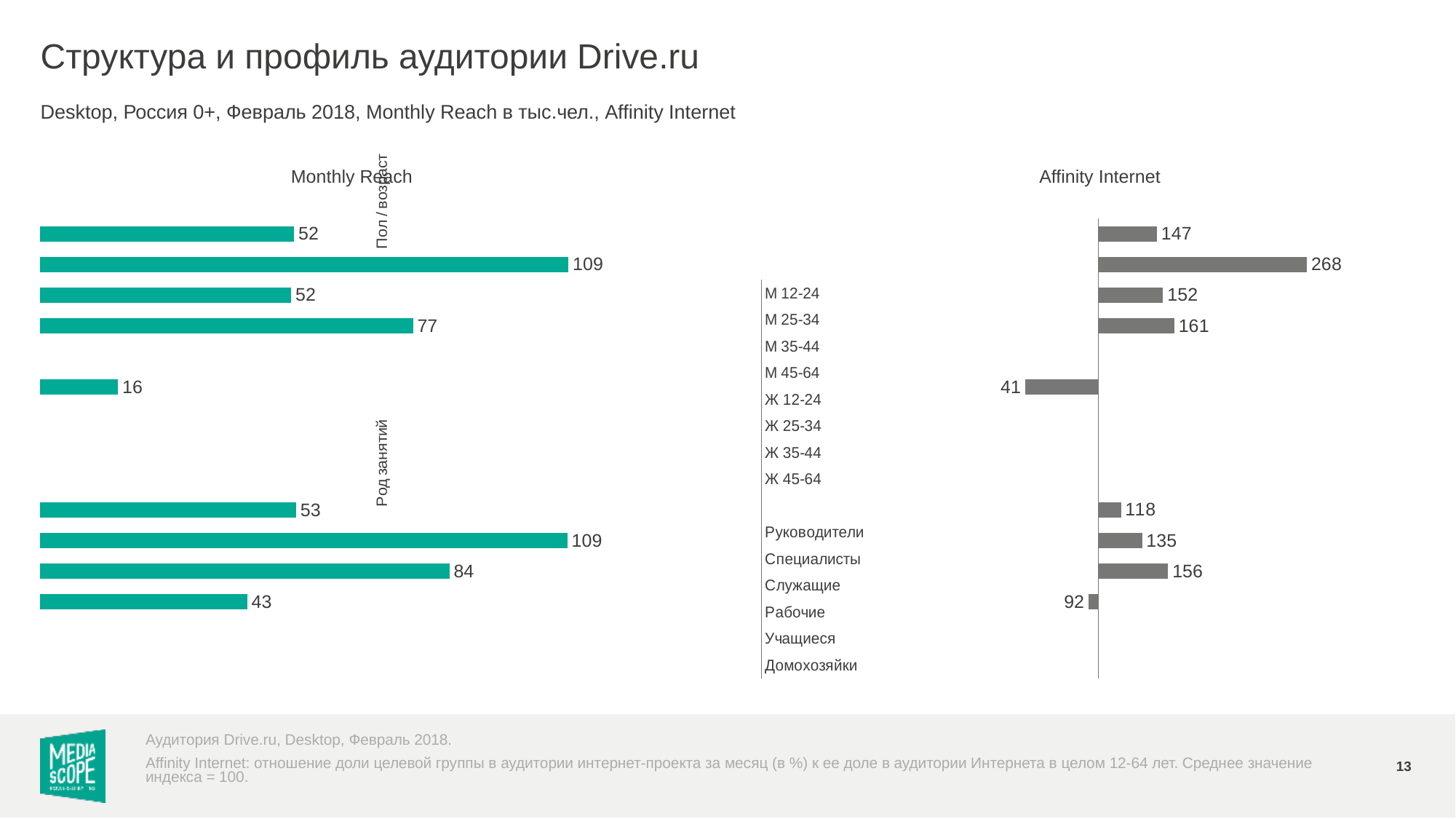
What kind of chart is the Monthly Reach chart on the left? Bar chart How many bars are plotted in the Affinity Internet chart? 9 In the Affinity Internet chart, what is the lowest value shown on any bar? 41 In the Affinity Internet chart, which is larger: the bar labelled 147 or the bar labelled 161? 161 In the Affinity Internet chart, what is the highest value shown on any bar? 268 What colour are the bars in the Monthly Reach chart? Teal (green) How many bars are plotted in the Monthly Reach chart? 9 In the Monthly Reach chart, what is the lowest value shown on any bar? 16 In the Monthly Reach chart, what is the difference between the highest value (109) and the lowest value (16)? 93 In the Monthly Reach chart, what is the highest value shown on any bar? 109 In the Affinity Internet chart, what is the difference between the highest value (268) and the lowest value (41)? 227 In the Affinity Internet chart, how many bars extend to the left of the vertical axis line? 2